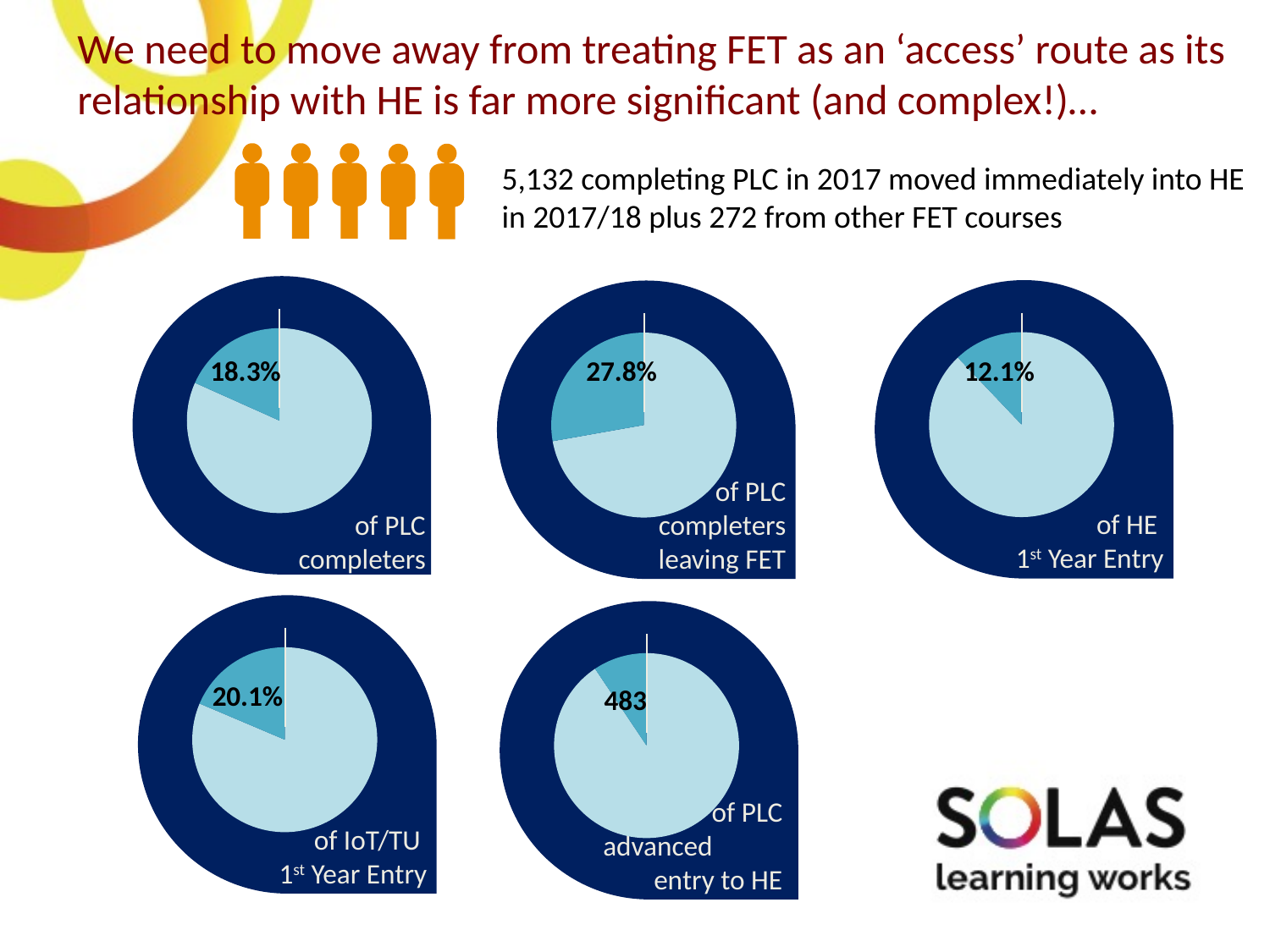
What percentage is shown on the pie chart labelled 'of PLC completers'? 18.3% What kind of charts are shown on the slide? Pie charts What is the difference between the percentage on the 'of PLC completers leaving FET' pie chart and the percentage on the 'of HE 1st Year Entry' pie chart? 15.7% Among the four pie charts showing percentages, which has the largest highlighted share? of PLC completers leaving FET Is the highlighted share on the 'of PLC completers' pie chart greater or less than 25%? less Which is larger: the percentage on the 'of IoT/TU 1st Year Entry' pie chart or the percentage on the 'of PLC completers' pie chart? of IoT/TU 1st Year Entry What percentage is shown on the pie chart labelled 'of HE 1st Year Entry'? 12.1% How many pie charts are on the slide? 5 Among the four pie charts showing percentages, which has the smallest highlighted share? of HE 1st Year Entry What percentage is shown on the pie chart labelled 'of PLC completers leaving FET'? 27.8% What value is shown on the pie chart labelled 'of PLC advanced entry to HE'? 483 What percentage is shown on the pie chart labelled 'of IoT/TU 1st Year Entry'? 20.1%